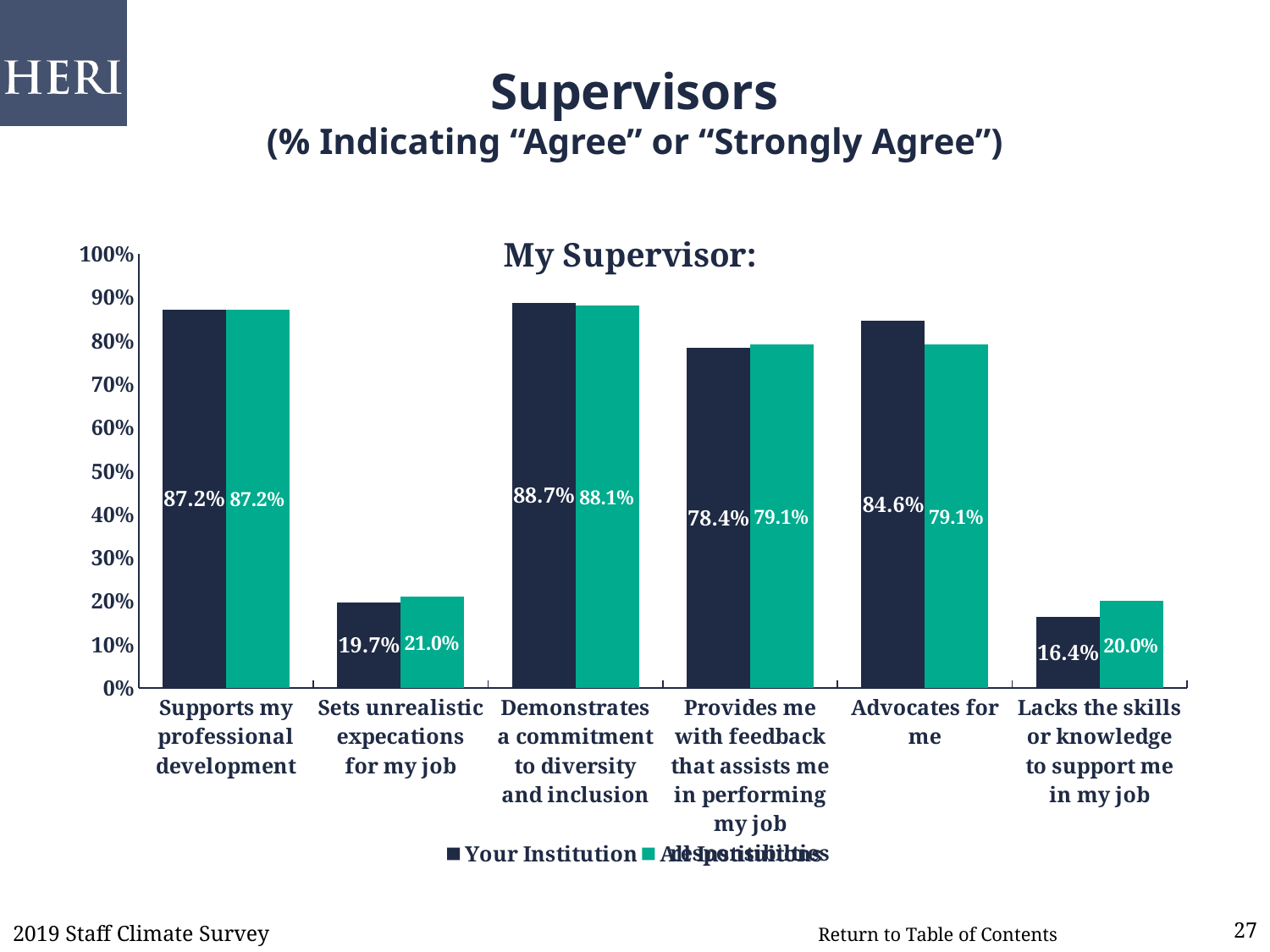
Is the value for "Your Institution" on "Sets unrealistic expecations for my job" greater or less than 30%? less How many categories are shown on the x axis? 6 What is the difference between "Your Institution" and "All Institutions" on "Advocates for me"? 5.5% What is the value for "All Institutions" on "Sets unrealistic expecations for my job"? 21.0% On "Provides me with feedback that assists me in performing my job responsibilities", which is larger: "Your Institution" or "All Institutions"? All Institutions What is the value for "All Institutions" on "Lacks the skills or knowledge to support me in my job"? 20.0% How many series does the legend list? 2 What is the value for "Your Institution" on "Supports my professional development"? 87.2% What is the value for "Your Institution" on "Advocates for me"? 84.6% Which category has the lowest value for "Your Institution"? Lacks the skills or knowledge to support me in my job Which category has the highest value for "Your Institution"? Demonstrates a commitment to diversity and inclusion What kind of chart is shown on the slide? bar chart